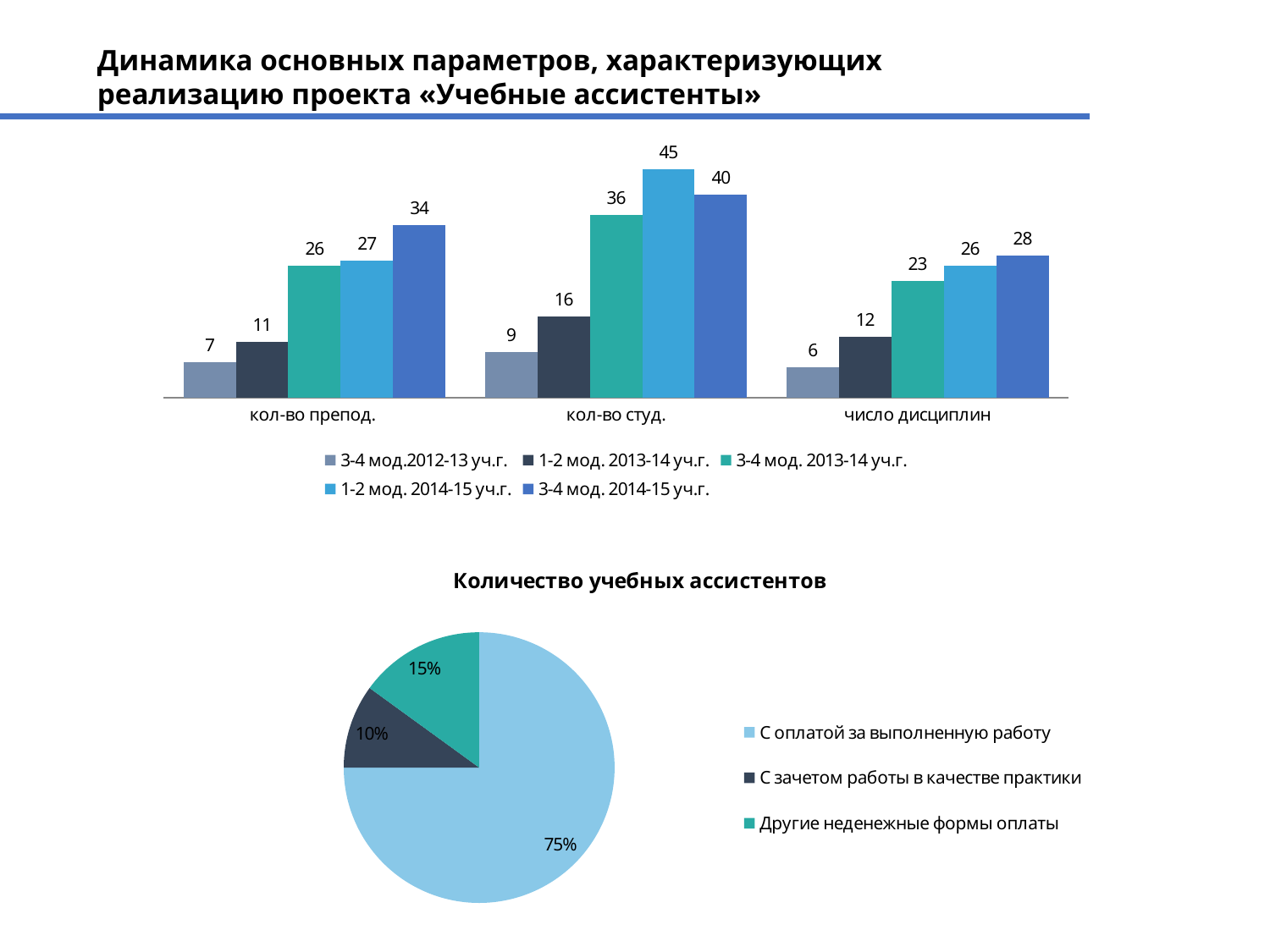
In the top bar chart, what is the value for число дисциплин in the series 3-4 мод.2012-13 уч.г.? 6 What type of chart is the chart titled Количество учебных ассистентов? pie chart In the top bar chart, which category has the lowest value in the series 3-4 мод.2012-13 уч.г.? число дисциплин In the pie chart Количество учебных ассистентов, which slice is the largest? С оплатой за выполненную работу In the top bar chart, which series has the highest value for кол-во студ.? 1-2 мод. 2014-15 уч.г. In the top bar chart, what is the difference between the 3-4 мод. 2014-15 уч.г. and 3-4 мод.2012-13 уч.г. values for кол-во препод.? 27 How many series does the legend of the top bar chart list? 5 In the top bar chart, what is the value for кол-во препод. in the series 3-4 мод. 2014-15 уч.г.? 34 In the pie chart Количество учебных ассистентов, what share is С зачетом работы в качестве практики? 10% In the top bar chart, what is the value for кол-во студ. in the series 1-2 мод. 2014-15 уч.г.? 45 How many categories are shown on the x axis of the top bar chart? 3 In the top bar chart, which is larger for кол-во студ.: the 1-2 мод. 2014-15 уч.г. value or the 3-4 мод. 2014-15 уч.г. value? 1-2 мод. 2014-15 уч.г.